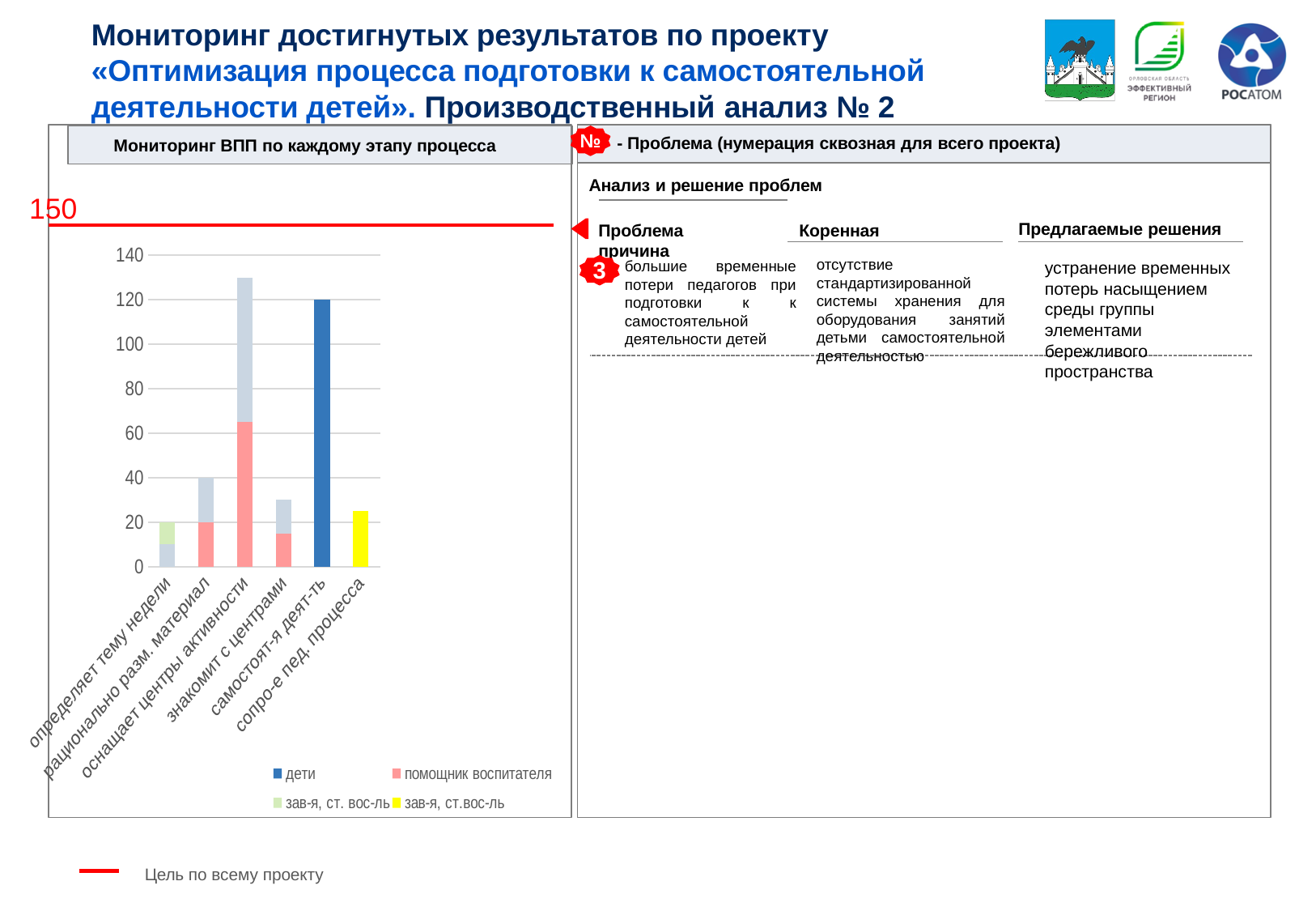
Is the total value for "знакомит с центрами" greater or less than 40? less How many categories are shown on the x axis of the chart? 6 Is the value for "сопро-е пед. процесса" greater or less than 40? less How many series does the chart legend list? 4 Which category has the tallest bar in the chart? оснащает центры активности Is the total value for "оснащает центры активности" greater or less than 100? greater Which bar is taller: "самостоят-я деят-ть" or "сопро-е пед. процесса"? самостоят-я деят-ть What does the red line represent, according to the note at the bottom of the slide? Цель по всему проекту What kind of chart is shown under "Мониторинг ВПП по каждому этапу процесса"? bar chart What is the value of the bar for "самостоят-я деят-ть"? 120 What value is marked by the red horizontal line above the chart? 150 Which bar is taller: "рационально разм. материал" or "знакомит с центрами"? рационально разм. материал